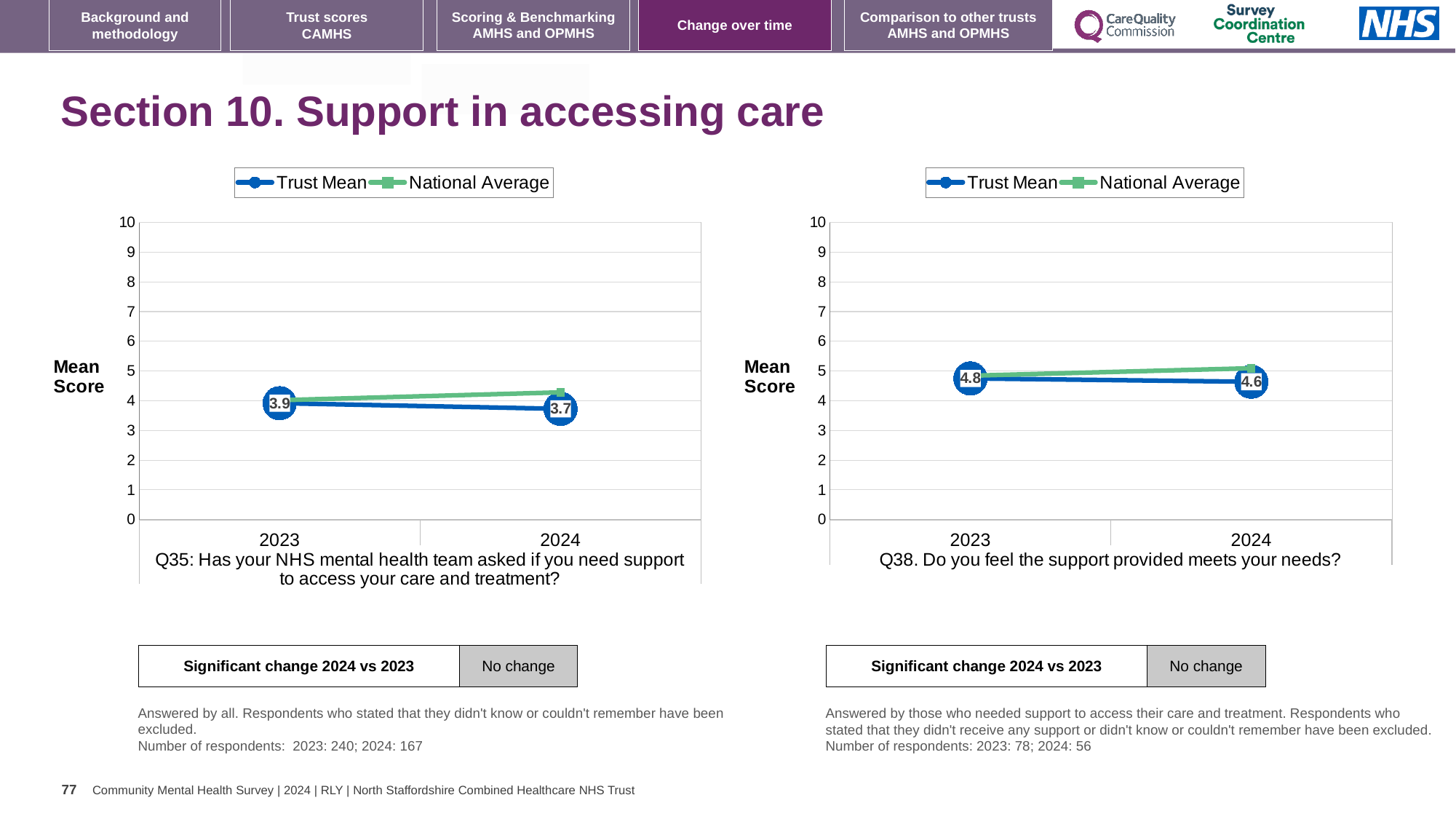
What kind of chart is the Q38 chart (right)? line chart How many years are plotted on the x axis of the Q38 chart (right)? 2 In the Q35 chart (left), by how much did the Trust Mean change from 2023 to 2024? 0.2 In the Q38 chart (right), what is the Trust Mean score for 2023? 4.8 In the Q35 chart (left), is the Trust Mean for 2024 greater or less than 4? less In the Q38 chart (right), what is the Trust Mean score for 2024? 4.6 In the Q38 chart (right), which series has the higher value in 2024, Trust Mean or National Average? National Average In the Q38 chart (right), does the Trust Mean rise or fall from 2023 to 2024? fall In the Q35 chart (left), does the National Average rise or fall from 2023 to 2024? rise In the Q35 chart (left), what is the Trust Mean score for 2024? 3.7 How many series does the legend of the Q35 chart (left) list? 2 In the Q35 chart (left), what is the Trust Mean score for 2023? 3.9